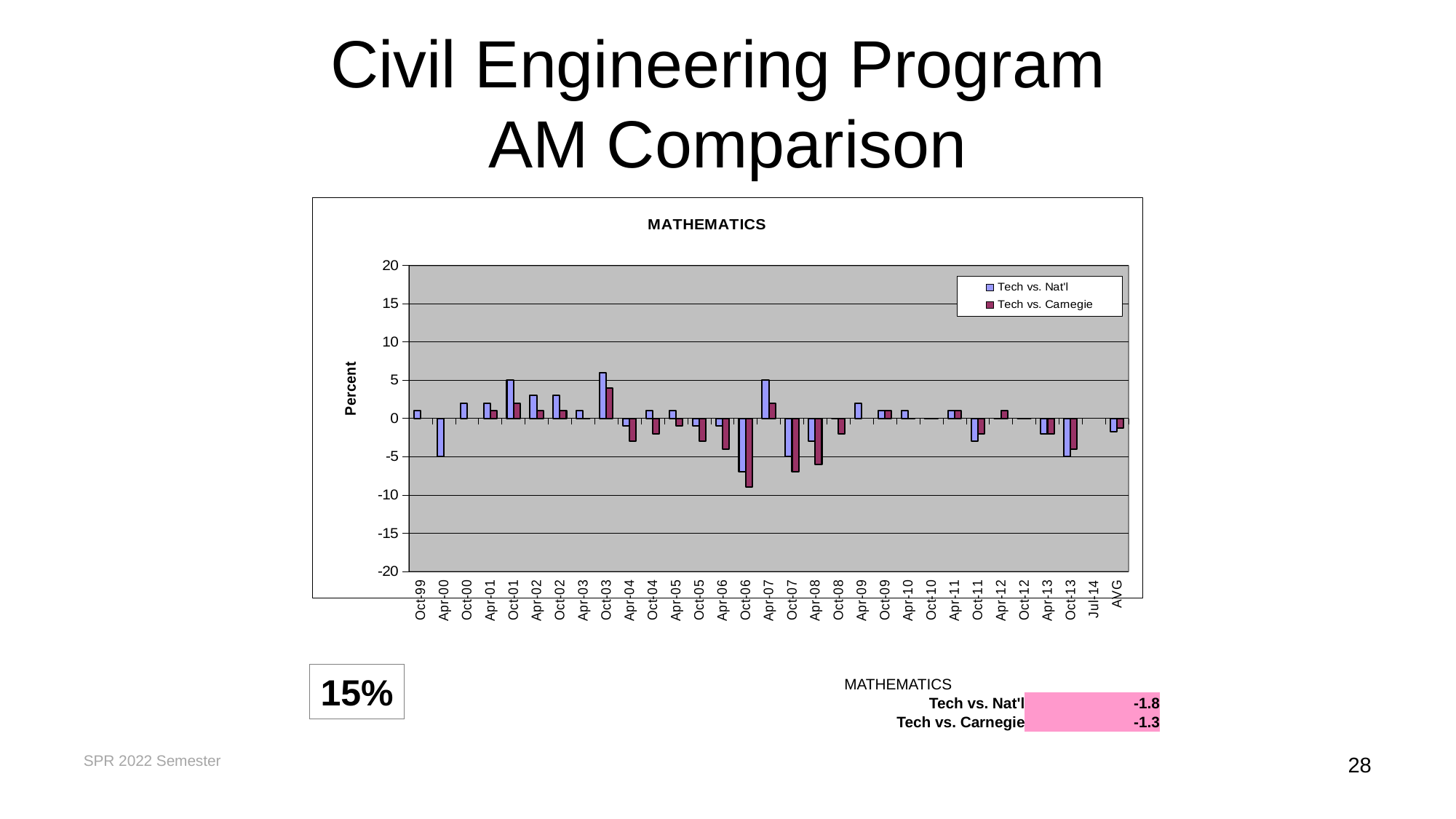
At Oct-06, which series has the lower value, Tech vs. Nat'l or Tech vs. Carnegie? Tech vs. Carnegie According to the table below the chart, what is the MATHEMATICS average value for Tech vs. Nat'l? -1.8 How many series does the legend of the MATHEMATICS chart list? 2 What is the label on the vertical axis of the chart? Percent For which category is the Tech vs. Carnegie value lowest? Oct-06 How many categories are shown along the x axis of the chart, including AVG? 31 Is the Tech vs. Nat'l value for Oct-03 greater or less than 5? greater What is the title of the chart? MATHEMATICS Is the Tech vs. Carnegie value for Oct-06 greater or less than -5? less What kind of chart is shown on the slide? bar chart Is the Tech vs. Carnegie value for Oct-07 greater or less than -5? less For which category is the Tech vs. Nat'l value highest? Oct-03